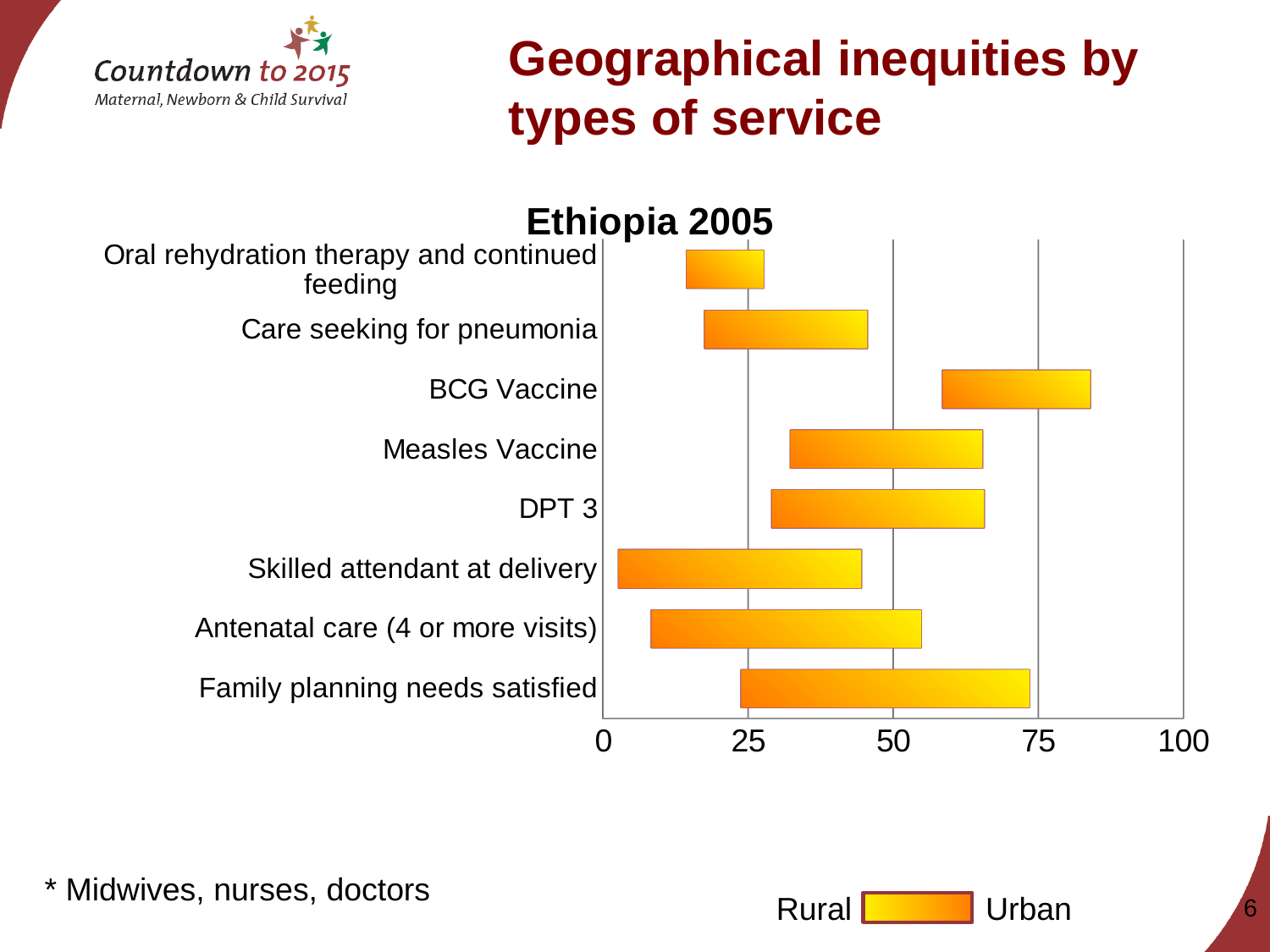
Which has the larger urban value, BCG Vaccine or Care seeking for pneumonia? BCG Vaccine Is the urban value for Oral rehydration therapy and continued feeding greater or less than 50? less What are the two ends of each bar labelled as in the legend? Rural and Urban Which service has the lowest rural value? Skilled attendant at delivery What kind of chart is shown on the slide? bar chart Which service has the highest urban value? BCG Vaccine How many service categories are plotted on the chart? 8 Is the rural value for Skilled attendant at delivery greater or less than 25? less What is the title of the chart? Ethiopia 2005 Is the urban value for Family planning needs satisfied greater or less than 50? greater Which service has the lowest urban value? Oral rehydration therapy and continued feeding